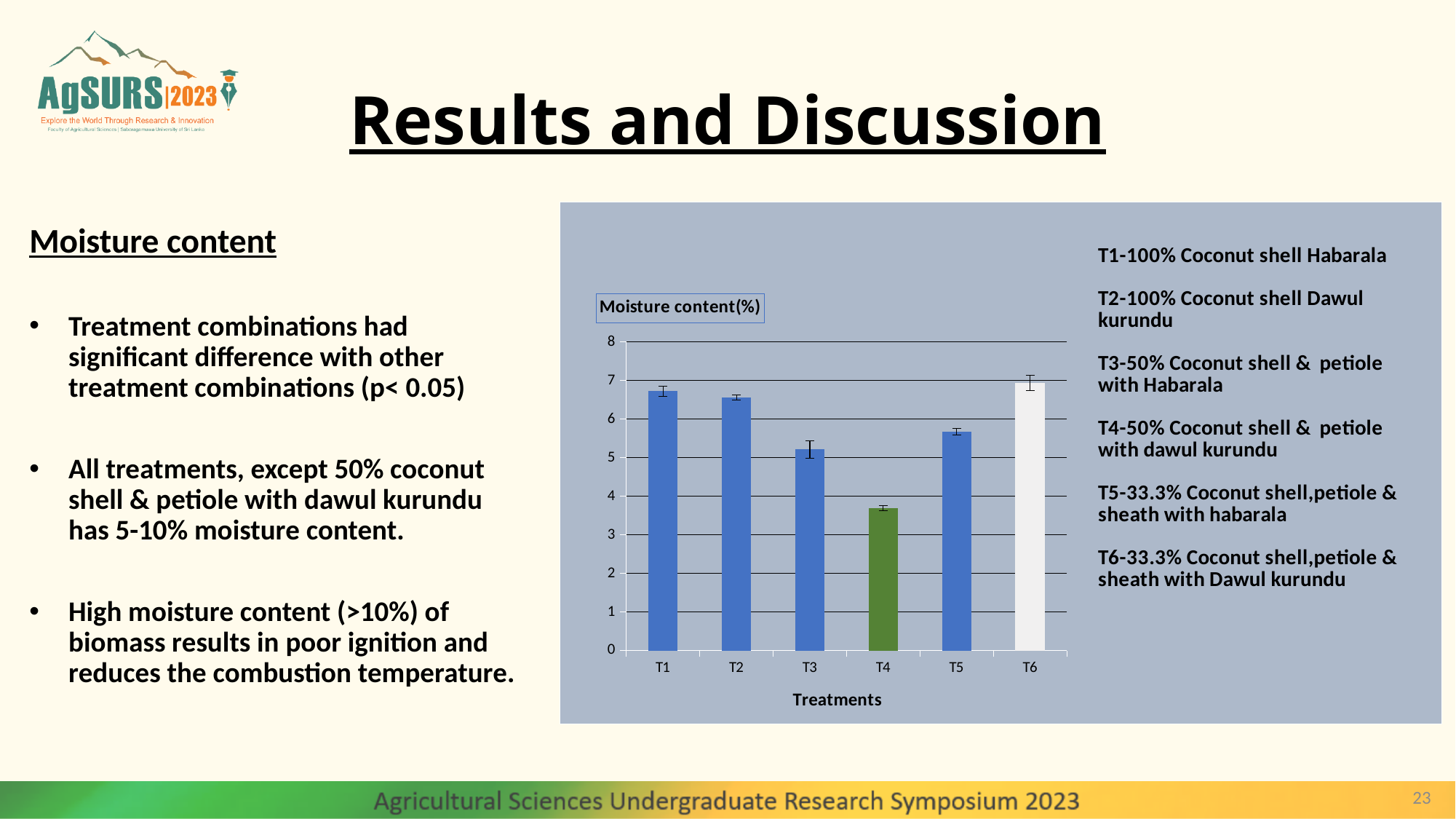
What is the title shown on the chart? Moisture content(%) Which treatment has the lowest moisture content in the chart? T4 Is the moisture content value for T4 greater or less than 4? less Is the moisture content value for T5 greater or less than 6? less Is the moisture content value for T3 greater or less than 5? greater How many treatments are plotted on the x axis of the chart? 6 Which has the higher moisture content, T4 or T3? T3 What is the label of the x axis of the chart? Treatments What kind of chart is shown on the slide? bar chart Which has the higher moisture content, T3 or T5? T5